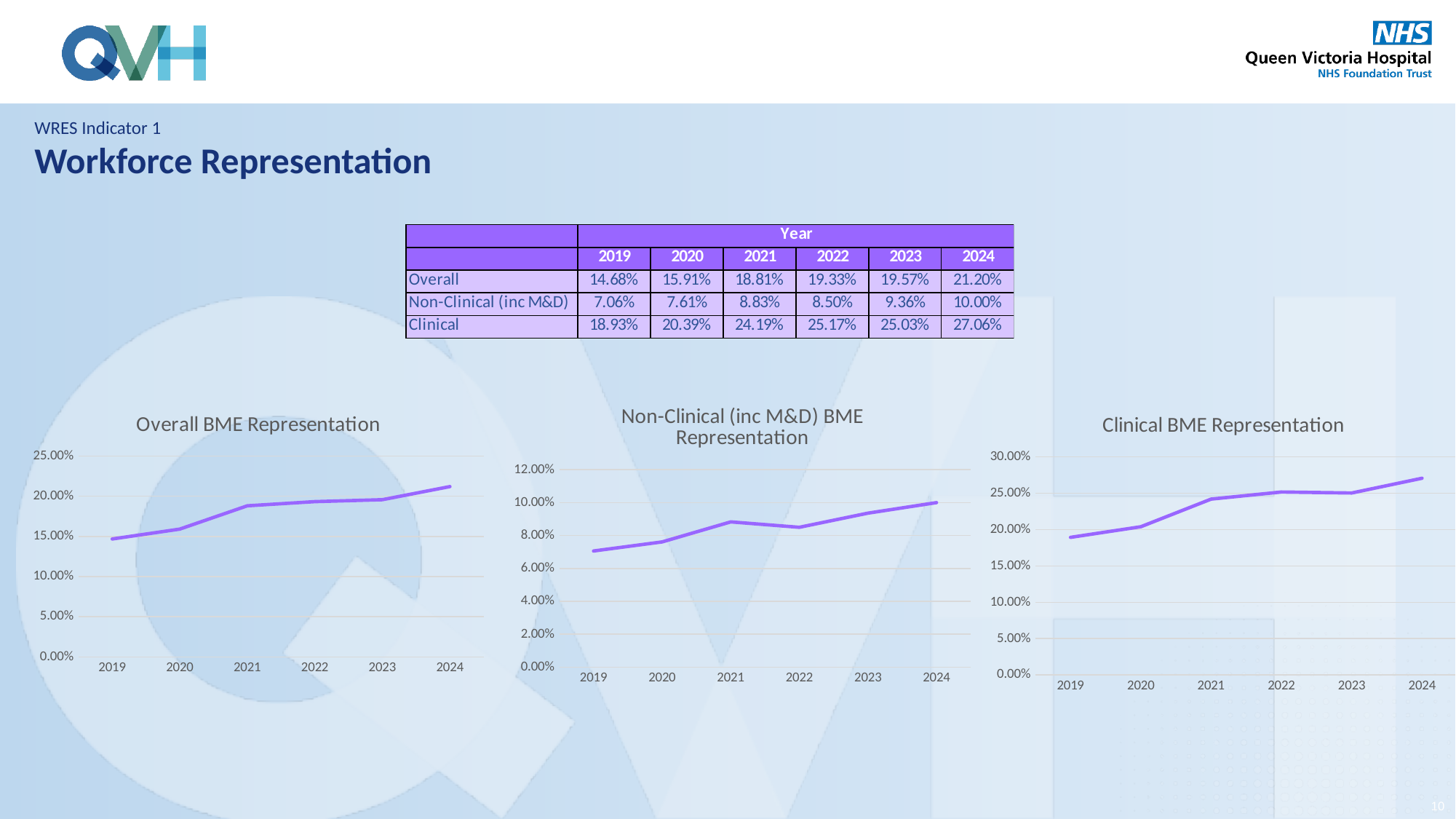
According to the table, what is the Clinical BME representation value for 2019? 18.93% What kind of chart is the "Overall BME Representation" chart? line chart In the "Overall BME Representation" chart, how many years are plotted on the x axis? 6 In the "Non-Clinical (inc M&D) BME Representation" chart, is the value for 2021 greater or less than the value for 2022? greater According to the table, what is the Non-Clinical (inc M&D) value for 2022? 8.50% In the "Non-Clinical (inc M&D) BME Representation" chart, which year has the lowest value? 2019 What is the title of the chart on the right of the slide? Clinical BME Representation In the "Clinical BME Representation" chart, which year has the highest value? 2024 According to the table, what is the Overall BME representation value for 2024? 21.20% In the "Overall BME Representation" chart, do the values generally rise or fall from 2019 to 2024? rise In the "Clinical BME Representation" chart, is the value for 2024 greater or less than 25.00%? greater Using the table values, what is the difference between the Overall value in 2024 and in 2019? 6.52%